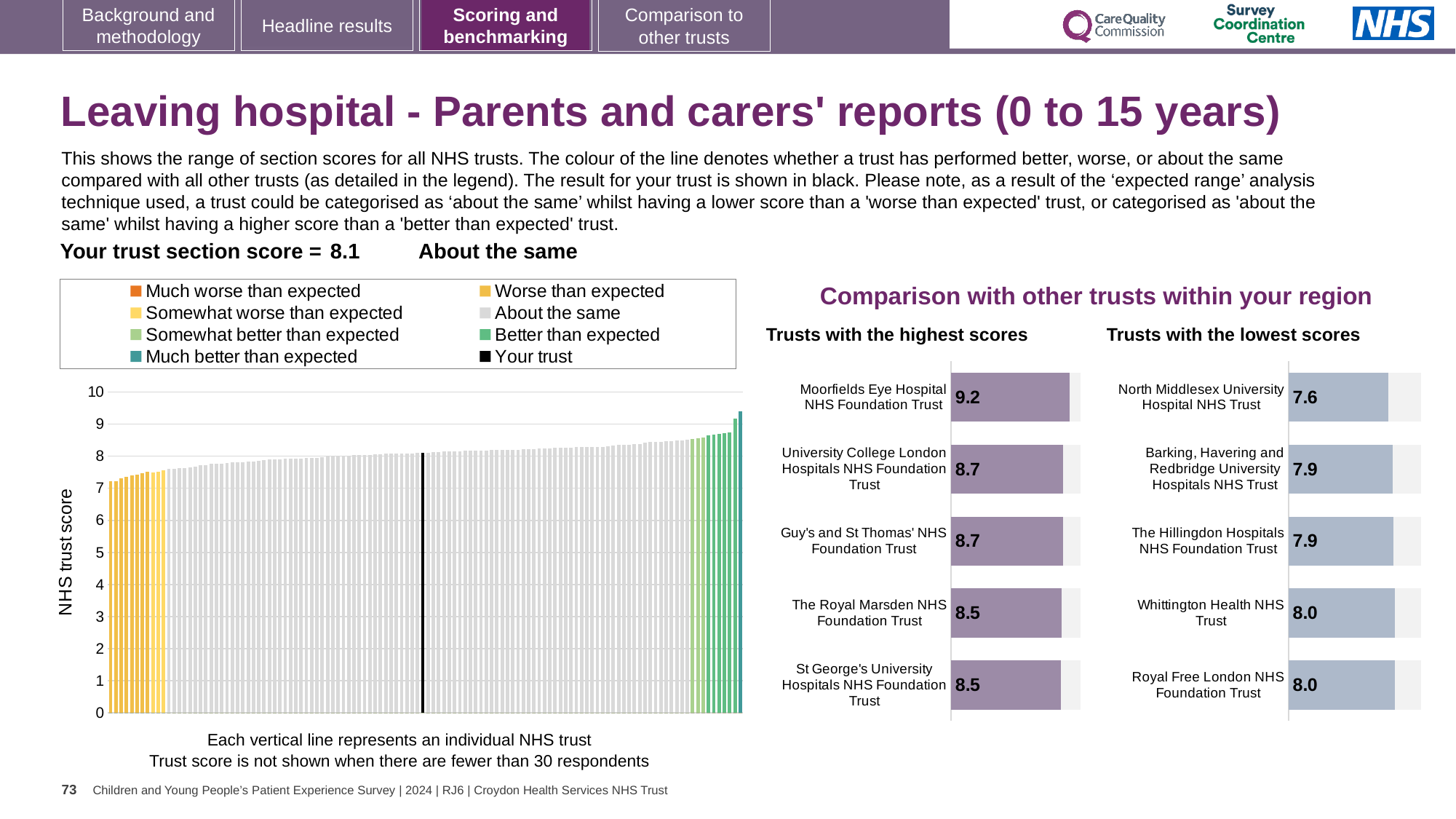
How many trusts are shown in the 'Trusts with the highest scores' chart? 5 In the 'Trusts with the highest scores' chart, what is the difference between the scores of Moorfields Eye Hospital NHS Foundation Trust and The Royal Marsden NHS Foundation Trust? 0.7 In the 'Trusts with the lowest scores' chart, which trust has the lowest score? North Middlesex University Hospital NHS Trust In the main 'NHS trust score' chart on the left, is the value for your trust (the black line) greater or less than 5? greater In the main 'NHS trust score' chart on the left, how many entries does the legend list? 8 In the 'Trusts with the lowest scores' chart, what is the difference between the scores of Whittington Health NHS Trust and North Middlesex University Hospital NHS Trust? 0.4 In the main 'NHS trust score' chart on the left, do the trust scores rise or fall from left to right? Rise In the 'Trusts with the highest scores' chart, what is the score for Moorfields Eye Hospital NHS Foundation Trust? 9.2 In the 'Trusts with the highest scores' chart, which trust has the highest score? Moorfields Eye Hospital NHS Foundation Trust What kind of chart is the main 'NHS trust score' chart on the left? Bar chart Which is larger: the score for Moorfields Eye Hospital NHS Foundation Trust in the highest scores chart, or the score for North Middlesex University Hospital NHS Trust in the lowest scores chart? Moorfields Eye Hospital NHS Foundation Trust In the 'Trusts with the lowest scores' chart, what is the score for North Middlesex University Hospital NHS Trust? 7.6